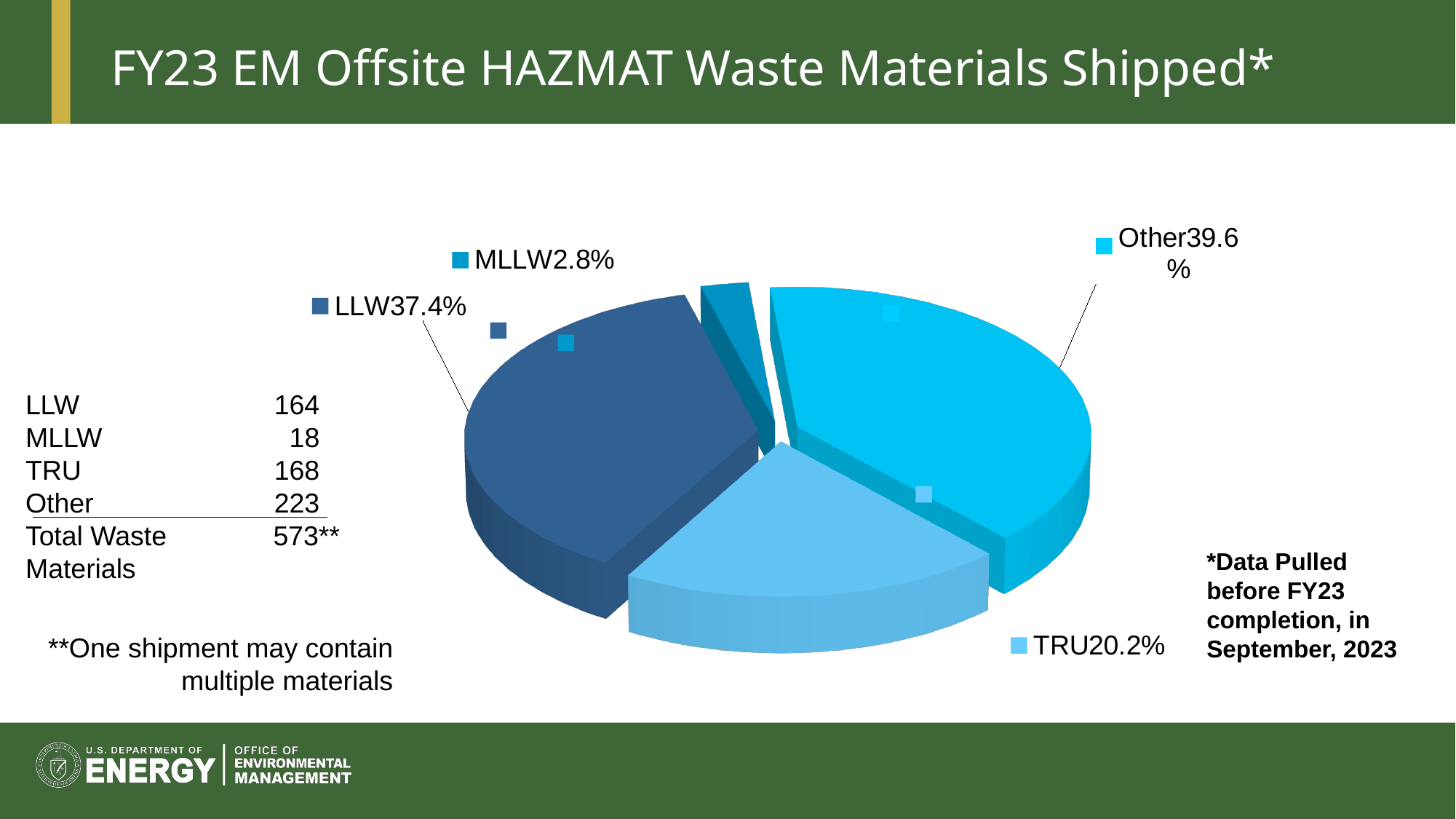
What kind of chart is shown on the slide? pie chart What is the title of the slide containing the pie chart? FY23 EM Offsite HAZMAT Waste Materials Shipped* What share of the pie is labelled for MLLW? 2.8% By how many percentage points does the Other slice exceed the LLW slice? 2.2 percentage points What share of the pie is labelled for Other? 39.6% What share of the pie is labelled for TRU? 20.2% Which slice is larger, LLW or TRU? LLW By how many percentage points does the LLW slice exceed the TRU slice? 17.2 percentage points How many slices does the pie chart have? 4 Which category has the smallest slice of the pie? MLLW Which category has the largest slice of the pie? Other